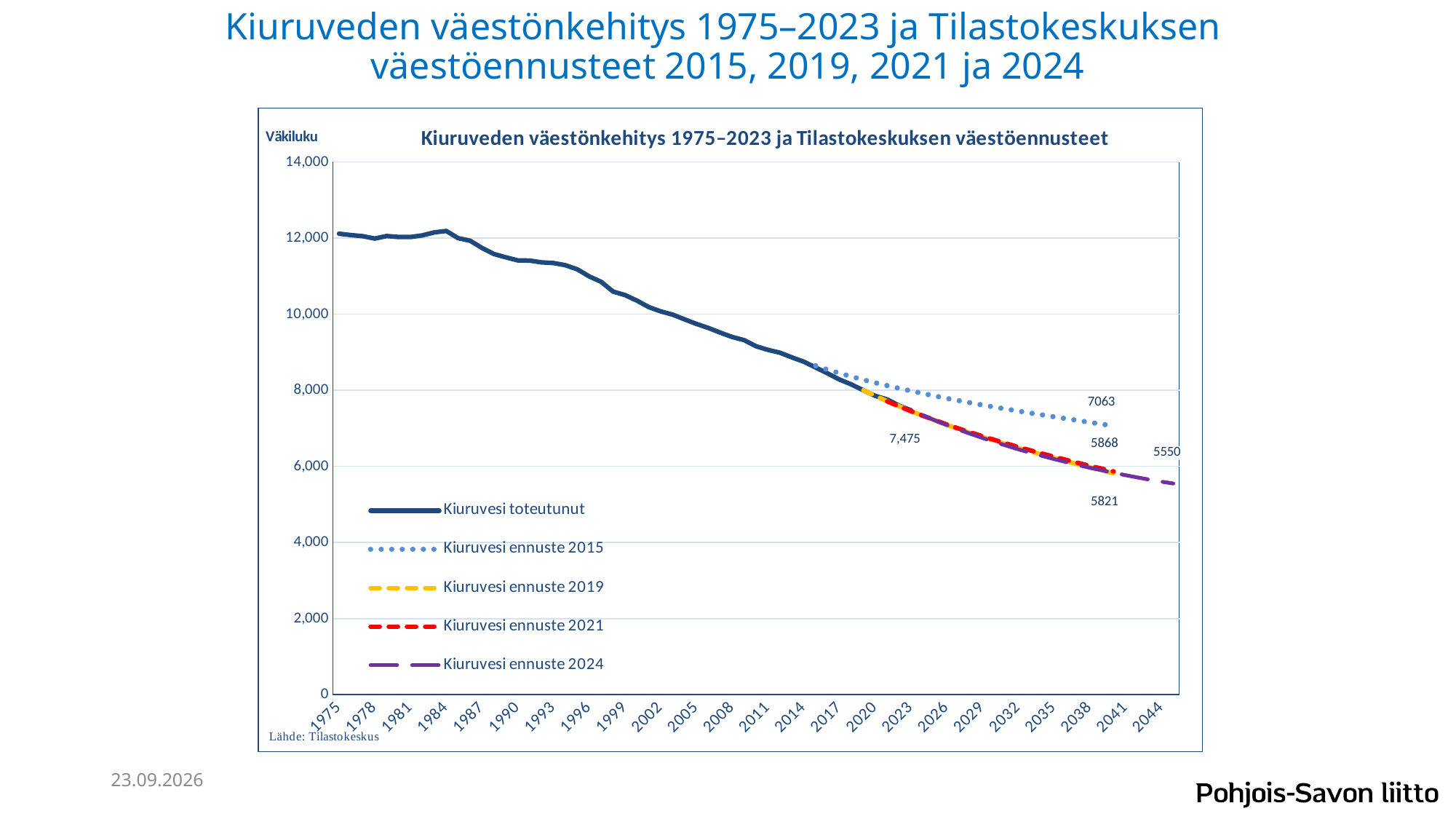
Does the Kiuruvesi toteutunut line rise or fall from 1975 to 2023? fall What value is labelled at the end of the Kiuruvesi ennuste 2024 line? 5550 How many series does the legend list? 5 What is the lowest data label printed on the chart? 5550 Is the Kiuruvesi toteutunut value for 2005 greater or less than 10,000? less Which forecast ends at a higher value, Kiuruvesi ennuste 2015 or Kiuruvesi ennuste 2024? Kiuruvesi ennuste 2015 What is the highest data label printed on the chart? 7,475 How many year labels are shown on the x axis? 24 What value is labelled at the end of the Kiuruvesi ennuste 2015 line? 7063 What is the difference between the labelled end values of the ennuste 2015 line (7063) and the ennuste 2024 line (5550)? 1513 What is the label on the vertical axis of the chart? Väkiluku What kind of chart is shown on the slide? line chart